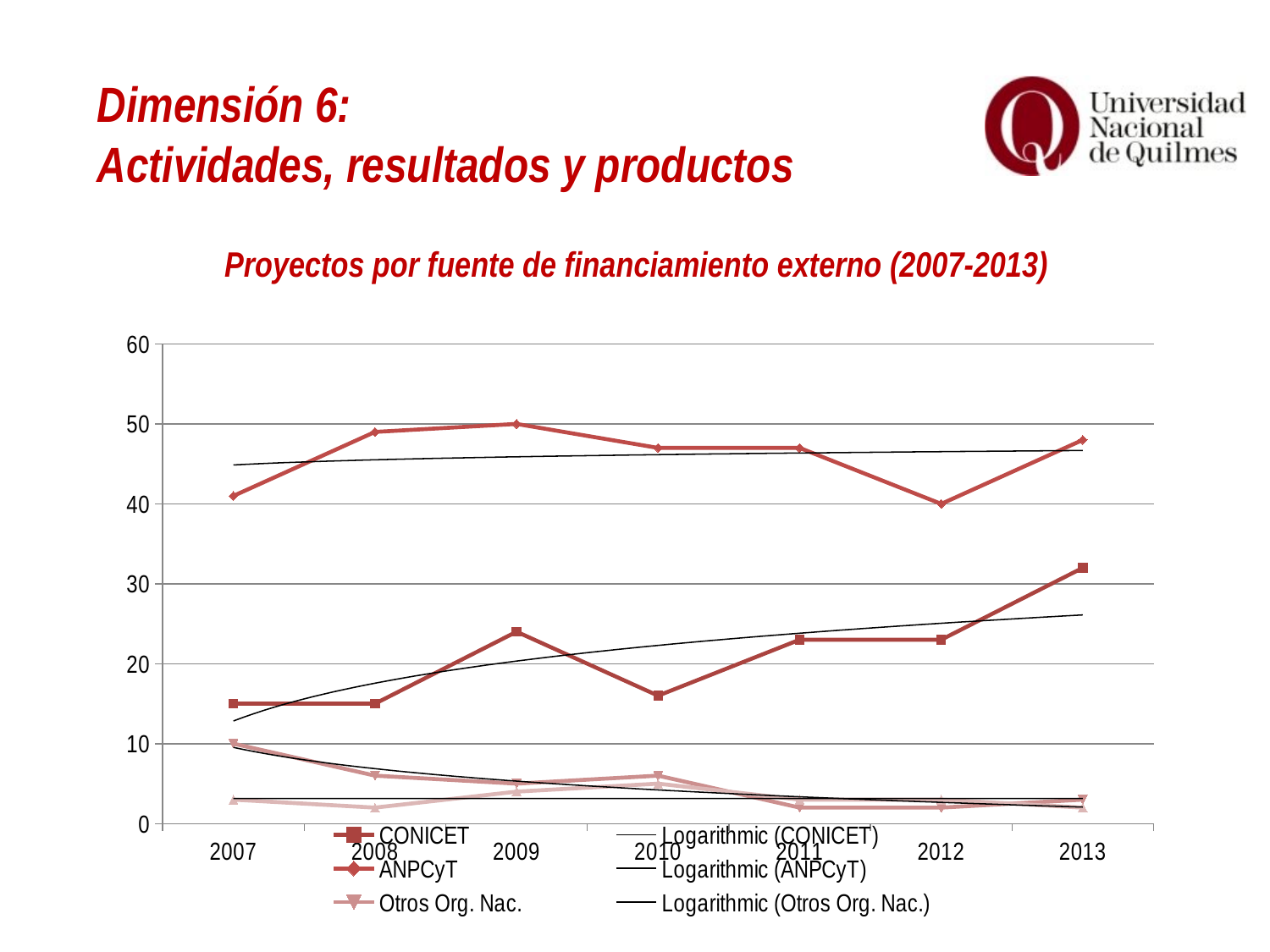
In which year does CONICET reach its highest value? 2013 Is the value for CONICET in 2007 greater or less than 20? less Is the value for Otros Org. Nac. in 2011 greater or less than 10? less In 2013, which series has the larger value, ANPCyT or CONICET? ANPCyT Is the value for ANPCyT in 2009 greater or less than 40? greater For CONICET, which year has the larger value, 2009 or 2010? 2009 How many entries does the legend list? 6 What is the title of the chart? Proyectos por fuente de financiamiento externo (2007-2013) How many years are plotted along the x axis? 7 What kind of chart is shown on the slide? Line chart